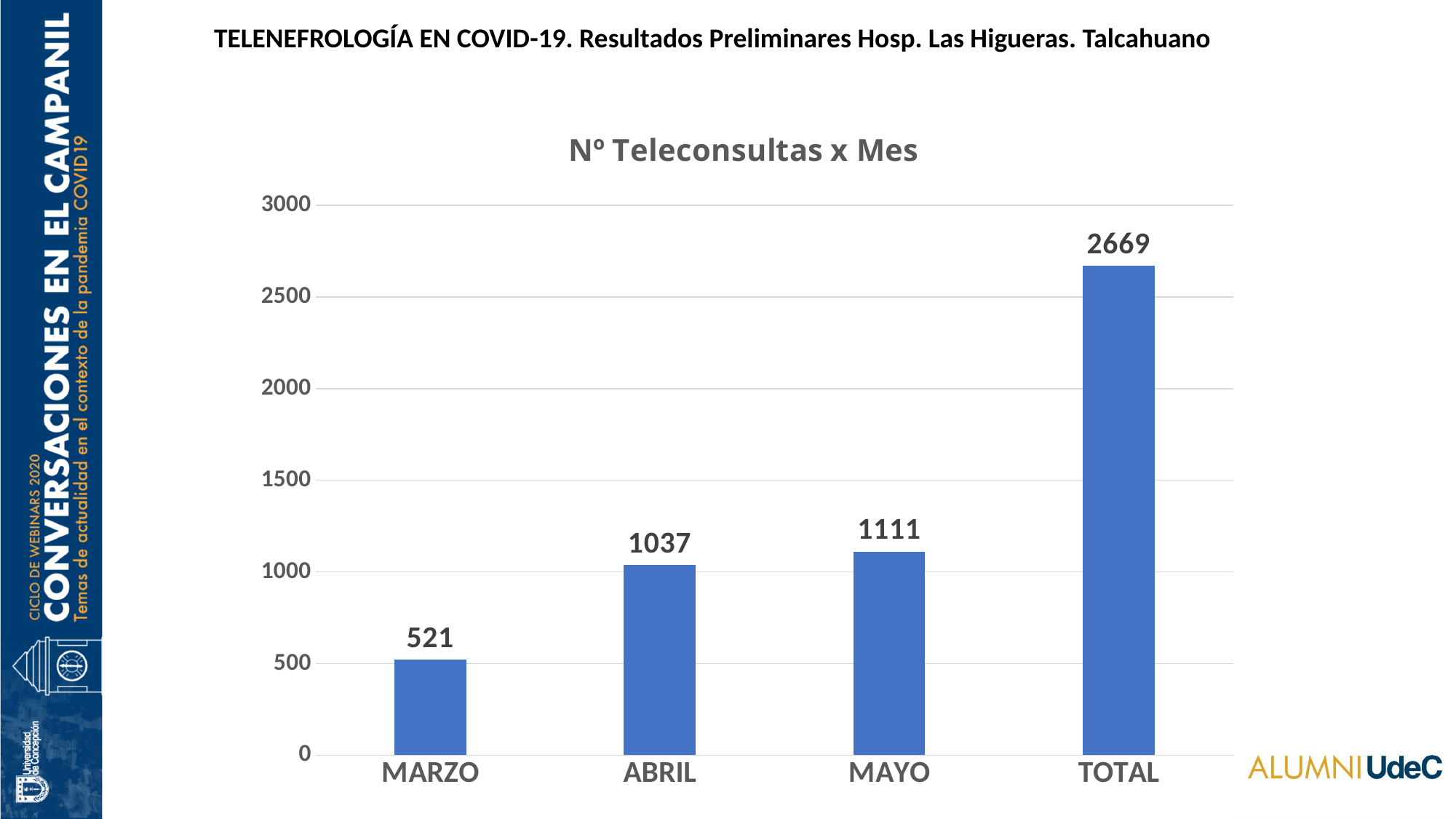
Which is larger, the value for MAYO or the value for ABRIL? MAYO What kind of chart is this? Bar chart What is the value for MARZO? 521 How many categories are shown on the x axis? 4 Which category has the lowest value? MARZO What is the difference between the values for ABRIL and MARZO? 516 Which category has the highest value? TOTAL What is the difference between the values for MAYO and ABRIL? 74 What is the value for TOTAL? 2669 What is the value for MAYO? 1111 What is the value for ABRIL? 1037 What is the title of the chart? Nº Teleconsultas x Mes